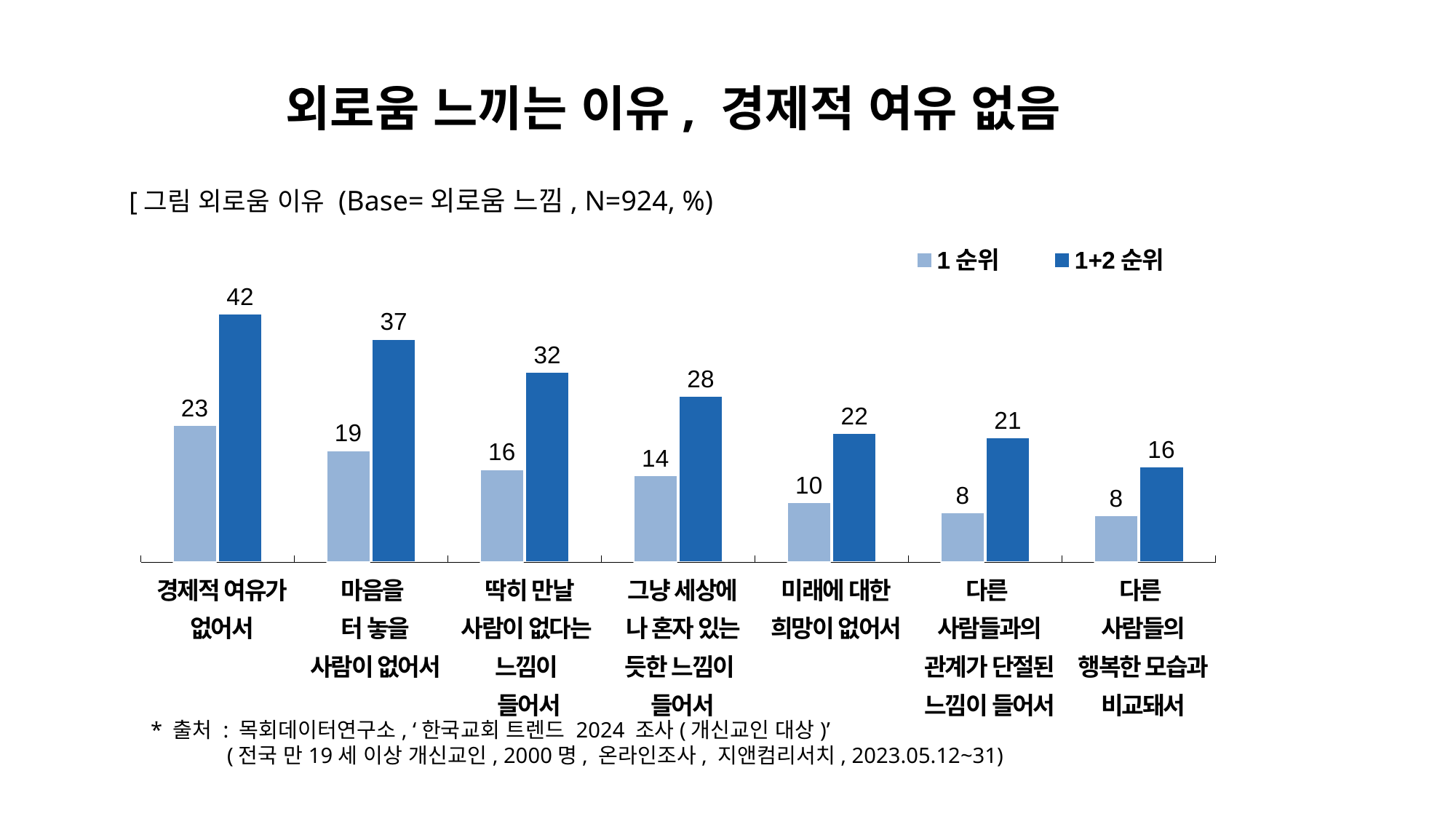
Which category has the lowest 1+2 순위 value? 다른 사람들의 행복한 모습과 비교돼서 Do the 1+2 순위 values rise or fall from left to right along the x axis? Fall What is the 1+2 순위 value for 그냥 세상에 나 혼자 있는 듯한 느낌이 들어서? 28 What kind of chart is shown on the slide? Bar chart Which category has the highest 1+2 순위 value? 경제적 여유가 없어서 What are the two legend entries of the chart? 1 순위, 1+2 순위 Which is larger: the 1 순위 value for 딱히 만날 사람이 없다는 느낌이 들어서 or the 1 순위 value for 그냥 세상에 나 혼자 있는 듯한 느낌이 들어서? 딱히 만날 사람이 없다는 느낌이 들어서 How many series does the legend list? 2 What is the difference between the 1+2 순위 and 1 순위 values for 마음을 터 놓을 사람이 없어서? 18 What is the 1+2 순위 value for 경제적 여유가 없어서? 42 What is the 1 순위 value for 미래에 대한 희망이 없어서? 10 How many categories are shown on the x axis? 7